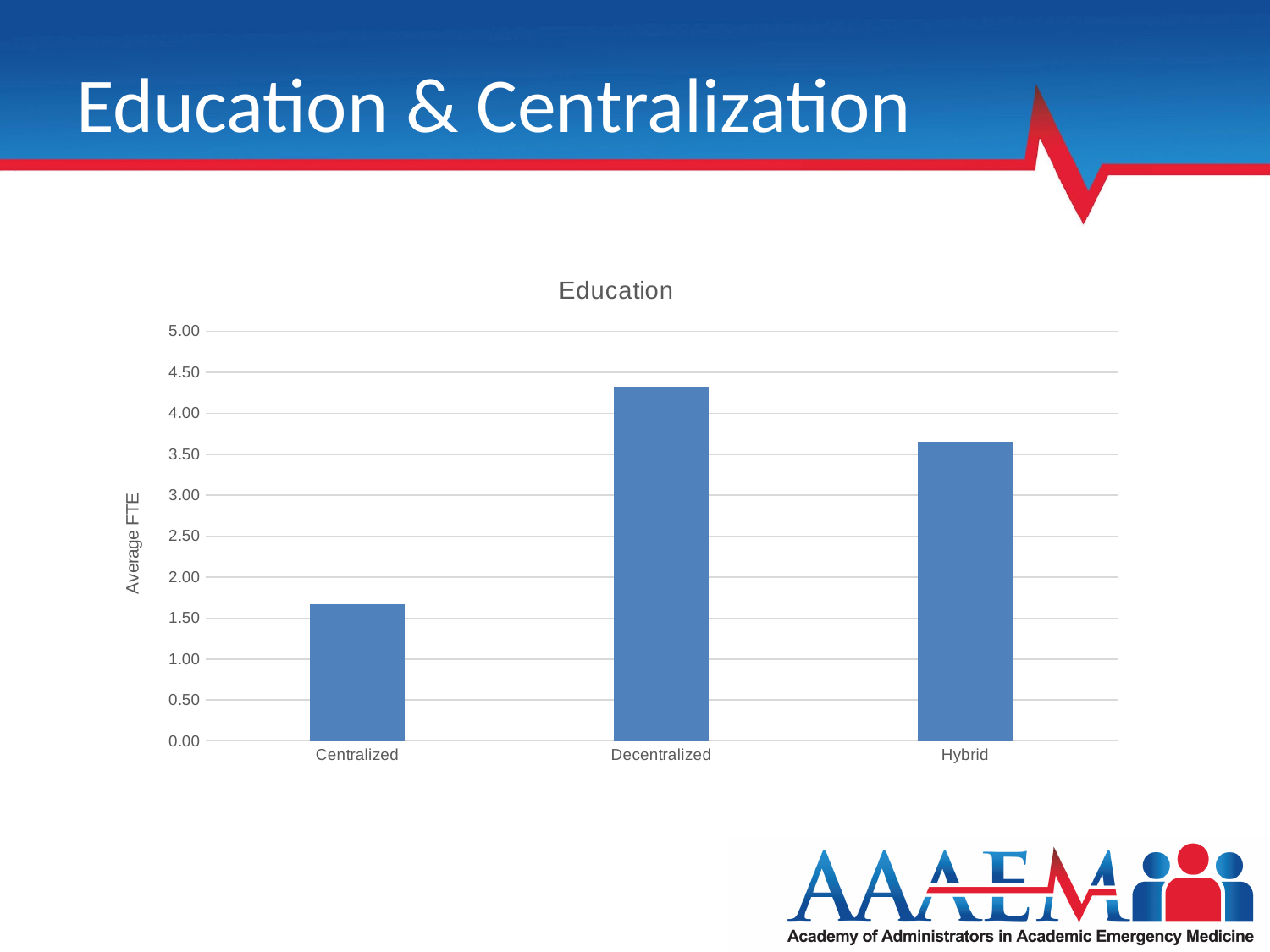
Which category has the highest average FTE? Decentralized Which has a larger average FTE, Centralized or Hybrid? Hybrid What type of chart is shown on the slide? bar chart Is the value for Hybrid greater or less than 3.50? greater How many categories are shown on the x axis of the chart? 3 Which category has the lowest average FTE? Centralized Is the value for Decentralized greater or less than 4.00? greater What is the title of the chart? Education Is the value for Centralized greater or less than 2.00? less What is the label on the vertical axis of the chart? Average FTE Which has a larger average FTE, Decentralized or Hybrid? Decentralized